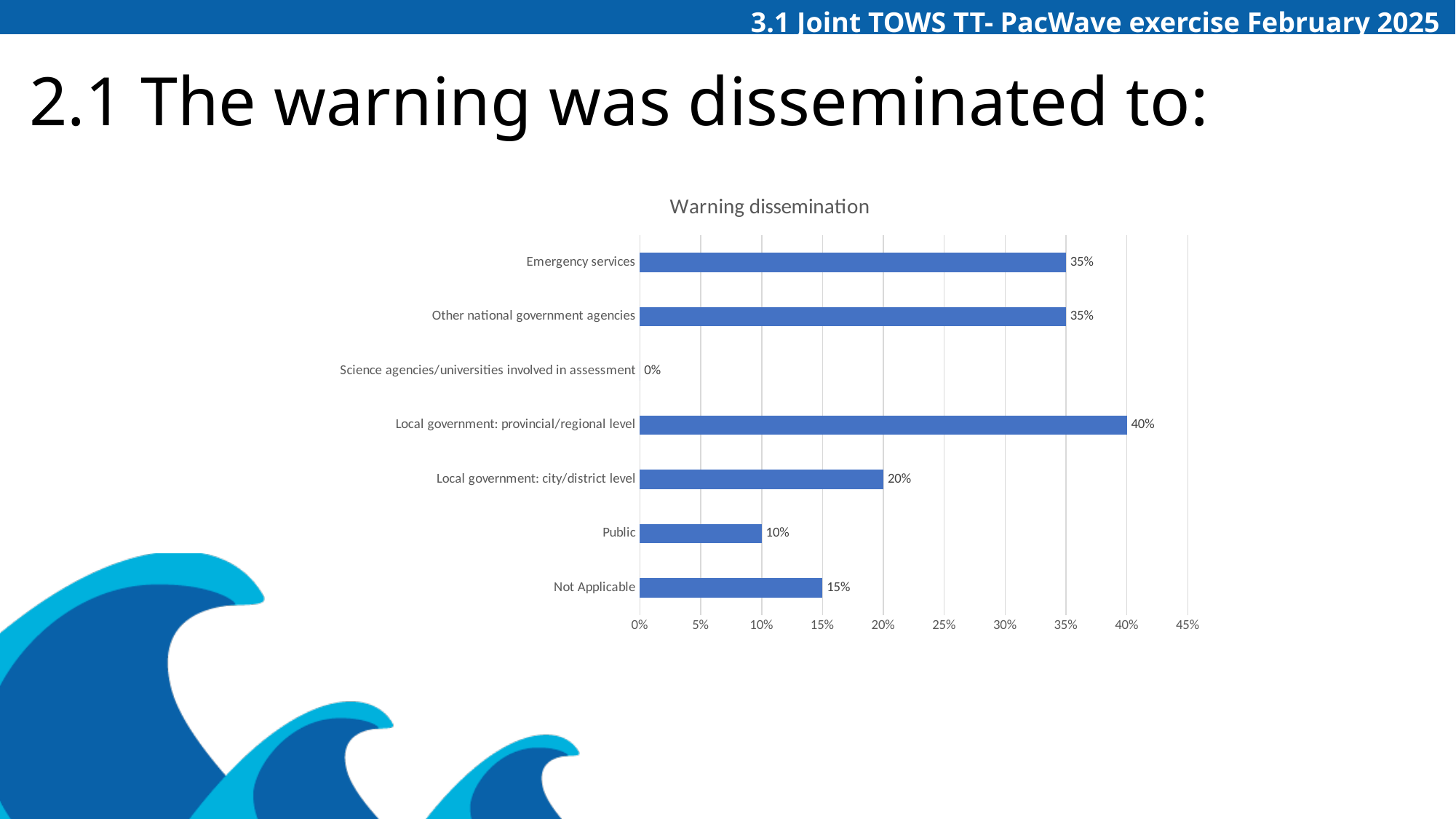
How many categories are shown in the chart? 7 Which is larger, Not Applicable or Public? Not Applicable What is the value for Local government: provincial/regional level? 40% What is the value for Public? 10% Which category has the lowest value? Science agencies/universities involved in assessment What kind of chart is shown? bar chart What is the title of the chart? Warning dissemination What is the value for Emergency services? 35% What is the difference between Local government: provincial/regional level and Local government: city/district level? 20% Which category has the highest value? Local government: provincial/regional level What is the value for Science agencies/universities involved in assessment? 0% Is the value for Other national government agencies greater or less than 30%? greater